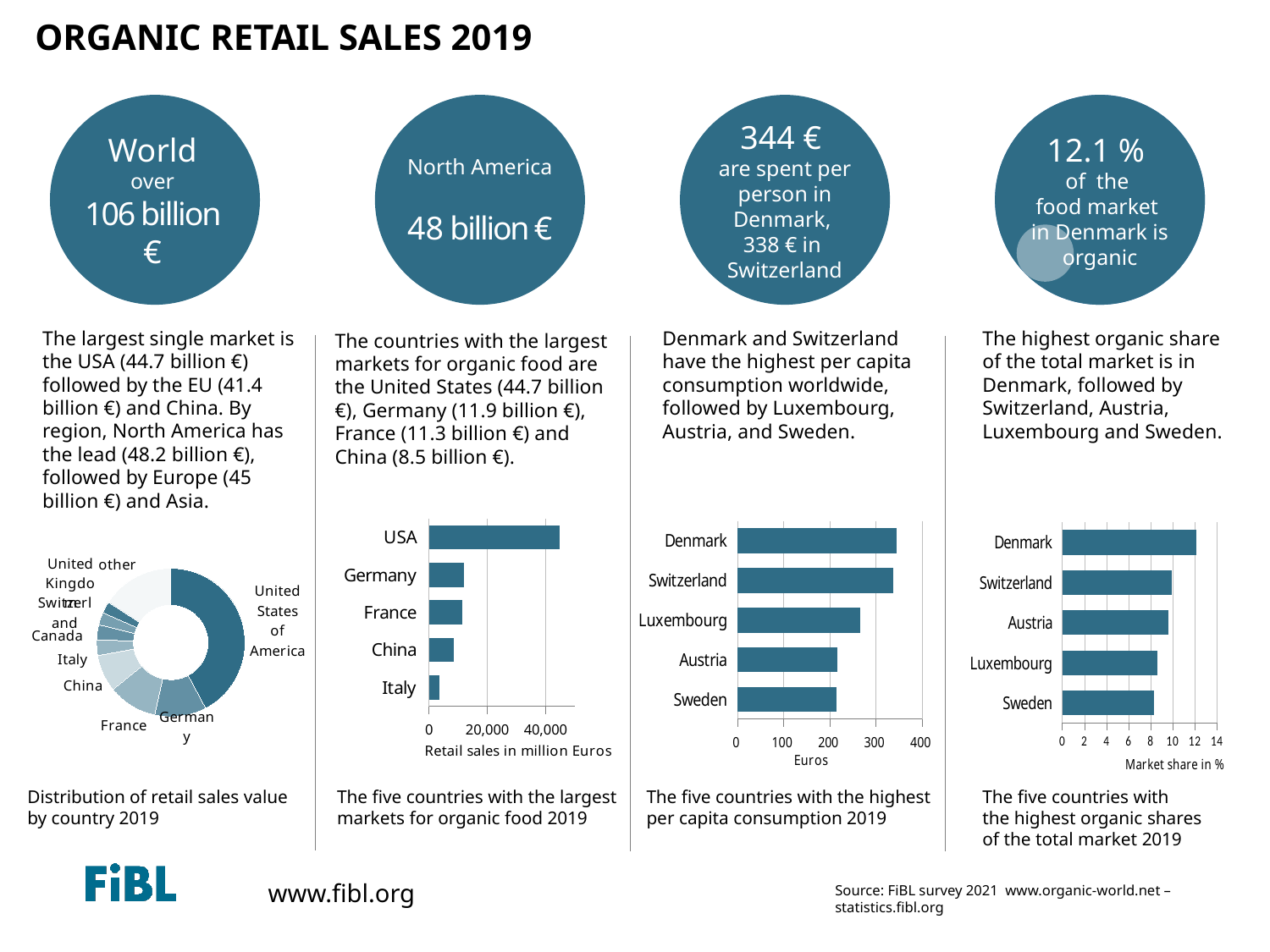
In the chart 'The five countries with the highest organic shares of the total market 2019', is the value for Sweden greater or less than 10? less In the chart 'The five countries with the highest per capita consumption 2019', is the value for Luxembourg greater or less than 300? less In the chart 'The five countries with the highest organic shares of the total market 2019', which country has the highest market share? Denmark In the chart 'Distribution of retail sales value by country 2019', which country has the largest slice? United States of America What is the x-axis label of the chart 'The five countries with the highest organic shares of the total market 2019'? Market share in % In the chart 'The five countries with the largest markets for organic food 2019', is the value for USA greater or less than 40,000? greater In the chart 'The five countries with the largest markets for organic food 2019', which country has the lowest retail sales? Italy In the chart 'The five countries with the highest organic shares of the total market 2019', do the bar values rise or fall going from Denmark at the top to Sweden at the bottom? fall What kind of chart is 'The five countries with the largest markets for organic food 2019'? bar chart How many countries are shown in the chart 'The five countries with the largest markets for organic food 2019'? 5 In the chart 'The five countries with the largest markets for organic food 2019', which country has the highest retail sales? USA In the chart 'The five countries with the highest per capita consumption 2019', which is larger, Luxembourg or Austria? Luxembourg